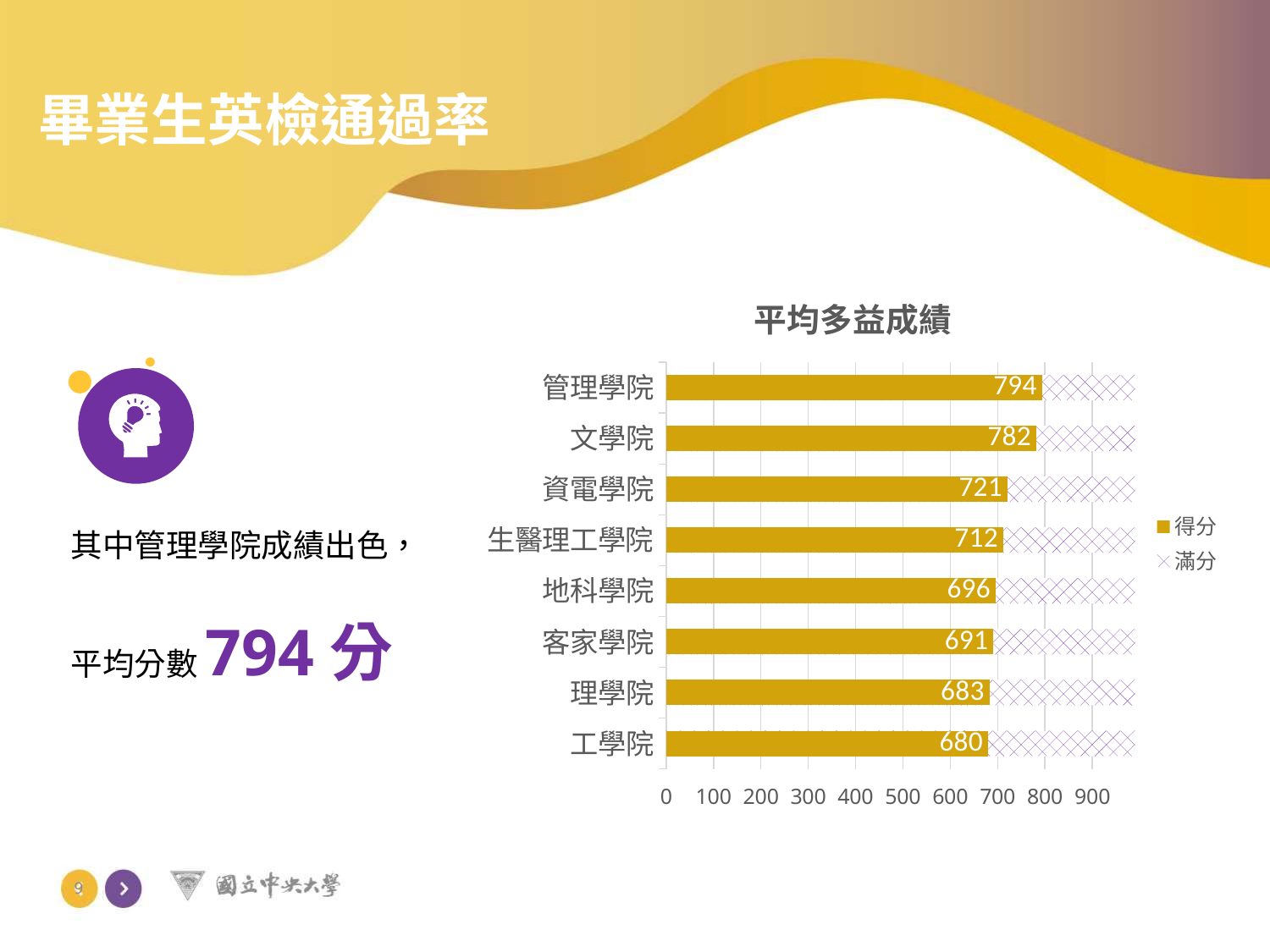
What is the difference between the 得分 values for 管理學院 and 工學院? 114 What kind of chart is shown on the slide? bar chart Which category has the highest 得分 value? 管理學院 How many categories are shown on the chart? 8 What is the 得分 value for 生醫理工學院? 712 What is the 得分 value for 地科學院? 696 Which has a larger 得分 value, 客家學院 or 理學院? 客家學院 What is the difference between the 得分 values for 文學院 and 資電學院? 61 What is the 得分 value for 管理學院? 794 Which category has the lowest 得分 value? 工學院 How many series does the legend list? 2 Is the 得分 value for 資電學院 greater or less than 700? greater